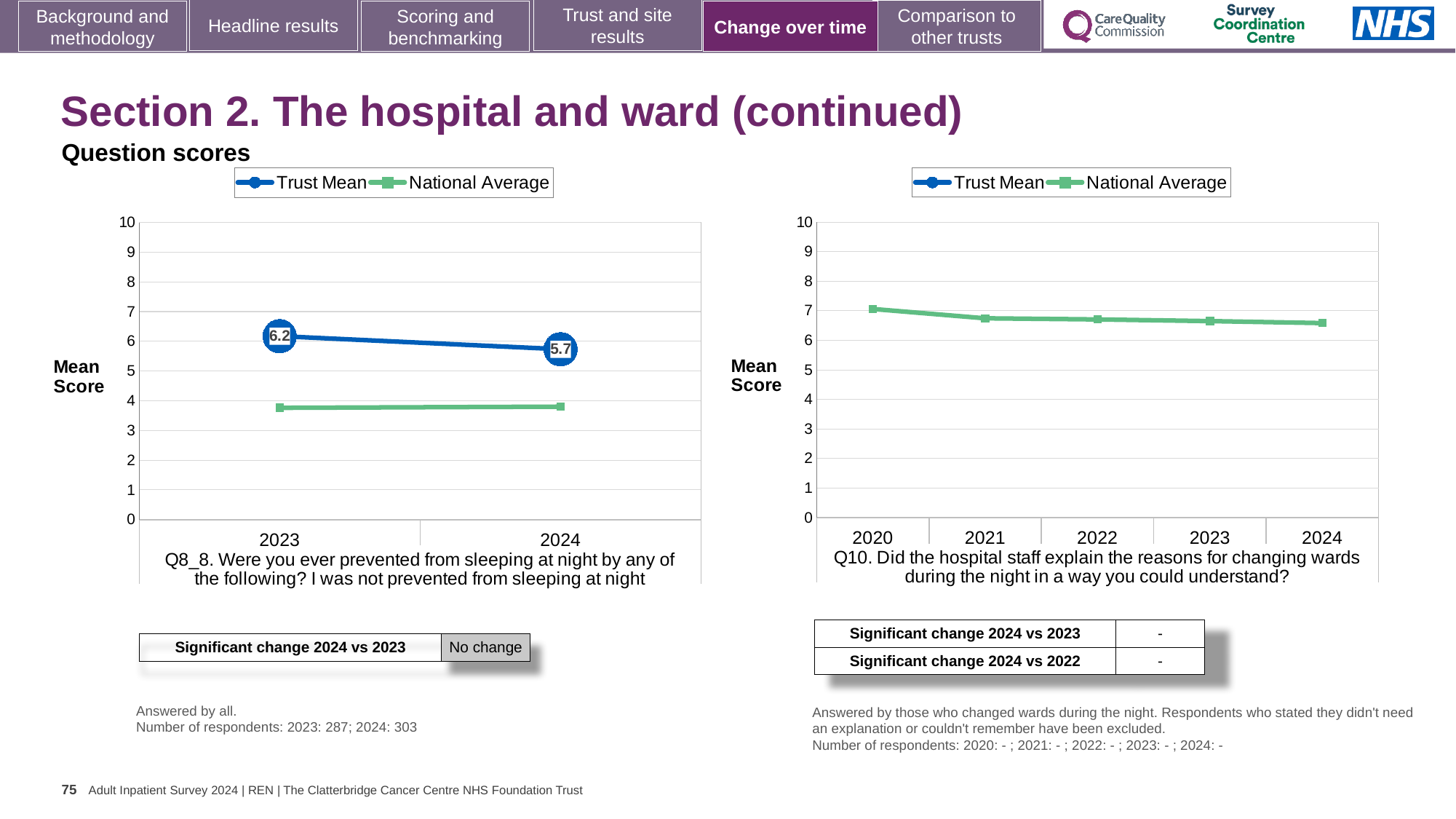
In the Q8_8 chart on the left, what is the Trust Mean score for 2023? 6.2 In the Q8_8 chart on the left, by how much did the Trust Mean score fall from 2023 to 2024? 0.5 In the Q8_8 chart on the left, is the National Average value for 2024 greater or less than 4? less What kind of chart is the Q10 chart on the right? line chart In the Q8_8 chart on the left, how many years are shown on the x axis? 2 In the Q8_8 chart on the left, does the Trust Mean rise or fall from 2023 to 2024? fall In the Q8_8 chart on the left, which year has the higher Trust Mean score, 2023 or 2024? 2023 In the Q8_8 chart on the left, how many series does the legend list? 2 In the Q10 chart on the right, does the National Average line rise or fall from 2020 to 2024? fall In the Q10 chart on the right, how many years are shown on the x axis? 5 In the Q8_8 chart on the left, what is the Trust Mean score for 2024? 5.7 In the Q10 chart on the right, is the National Average value for 2020 greater or less than 6? greater